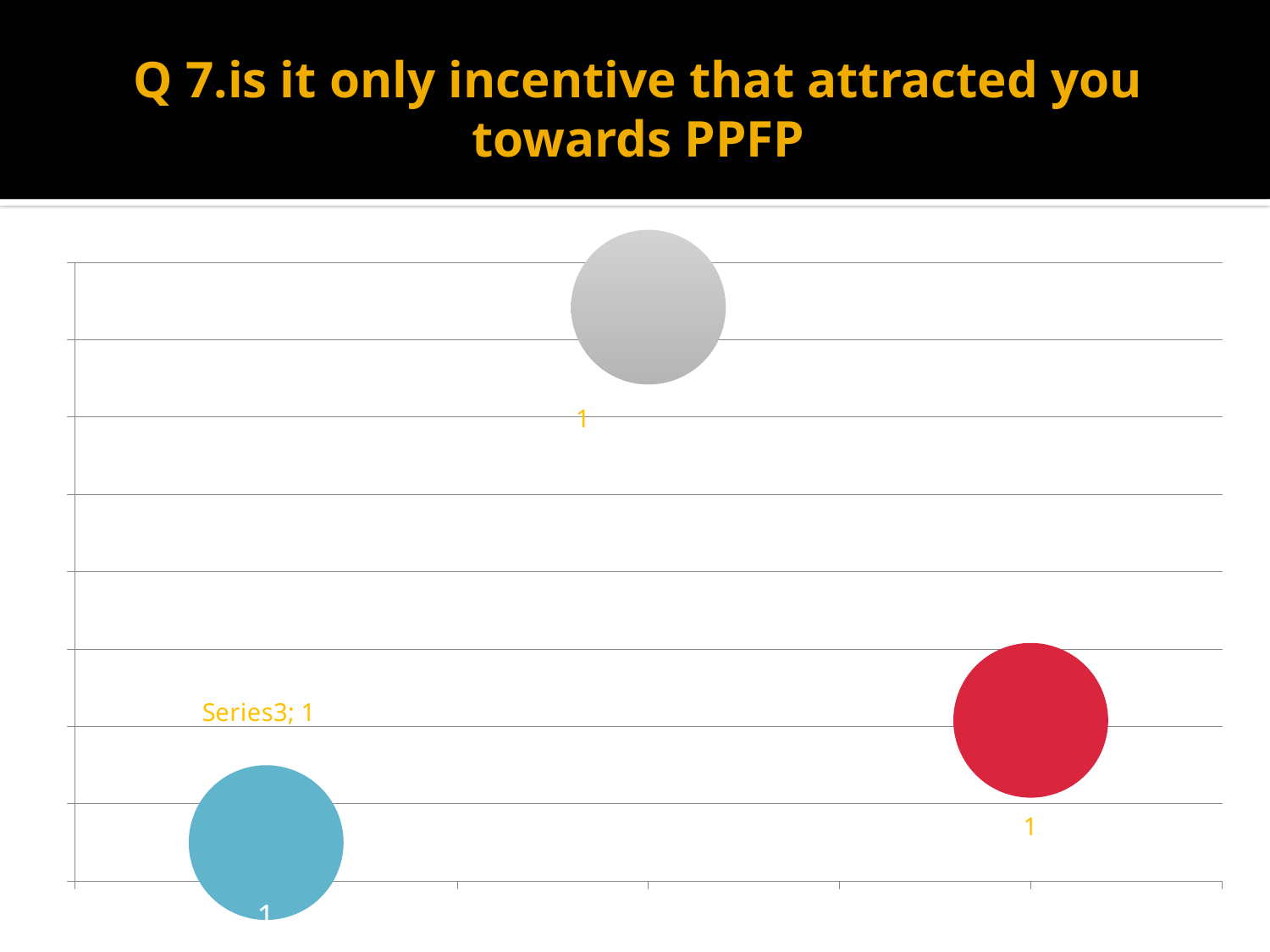
What is the title of the slide above the chart? Q 7.is it only incentive that attracted you towards PPFP Which bubble is positioned highest on the chart? the grey bubble What kind of chart is shown on the slide? bubble chart How many bubbles are plotted on the chart? 3 Which bubble is positioned lowest on the chart? the blue bubble What data label is printed next to the red bubble? 1 Which bubble is positioned higher on the chart, the red one or the blue one? the red one What data label is printed next to the grey bubble? 1 What label appears above the blue bubble? Series3; 1 Which series name is readable on the chart? Series3 What colours are the three bubbles on the chart? blue, grey and red